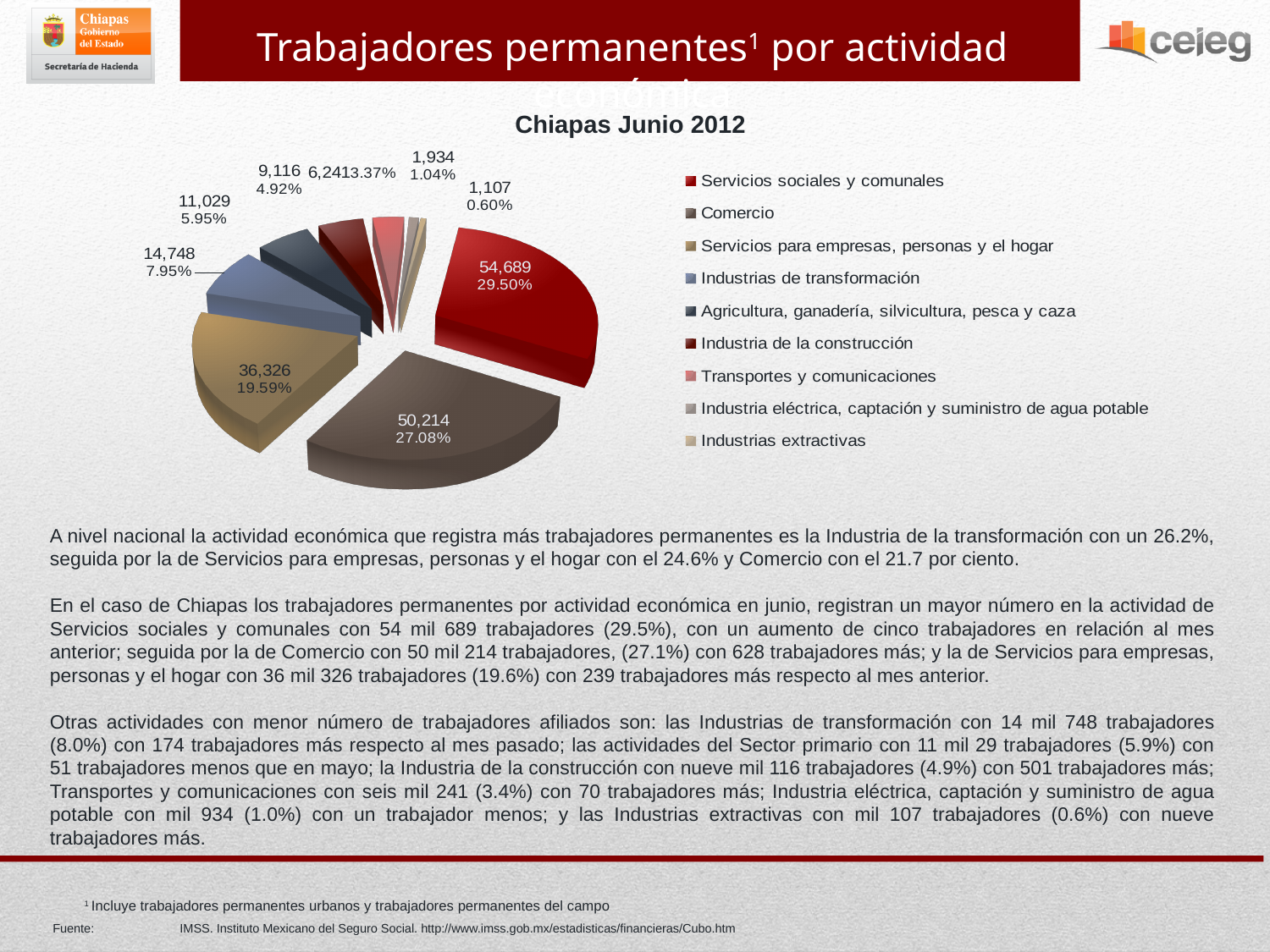
What is the value shown for Industrias de transformación? 14,748 What share of the pie does Comercio represent? 27.08% What share of the pie does Industrias extractivas represent? 0.60% What kind of chart is shown on the slide? Pie chart What is the value shown for Servicios para empresas, personas y el hogar? 36,326 Which category has the largest slice of the pie? Servicios sociales y comunales What is the value shown for Comercio? 50,214 What is the value shown for Servicios sociales y comunales? 54,689 How many categories does the pie chart legend list? 9 Which is larger, the value for Industria de la construcción or the value for Transportes y comunicaciones? Industria de la construcción What is the difference between the values for Servicios sociales y comunales and Comercio? 4,475 Which category has the smallest slice of the pie? Industrias extractivas